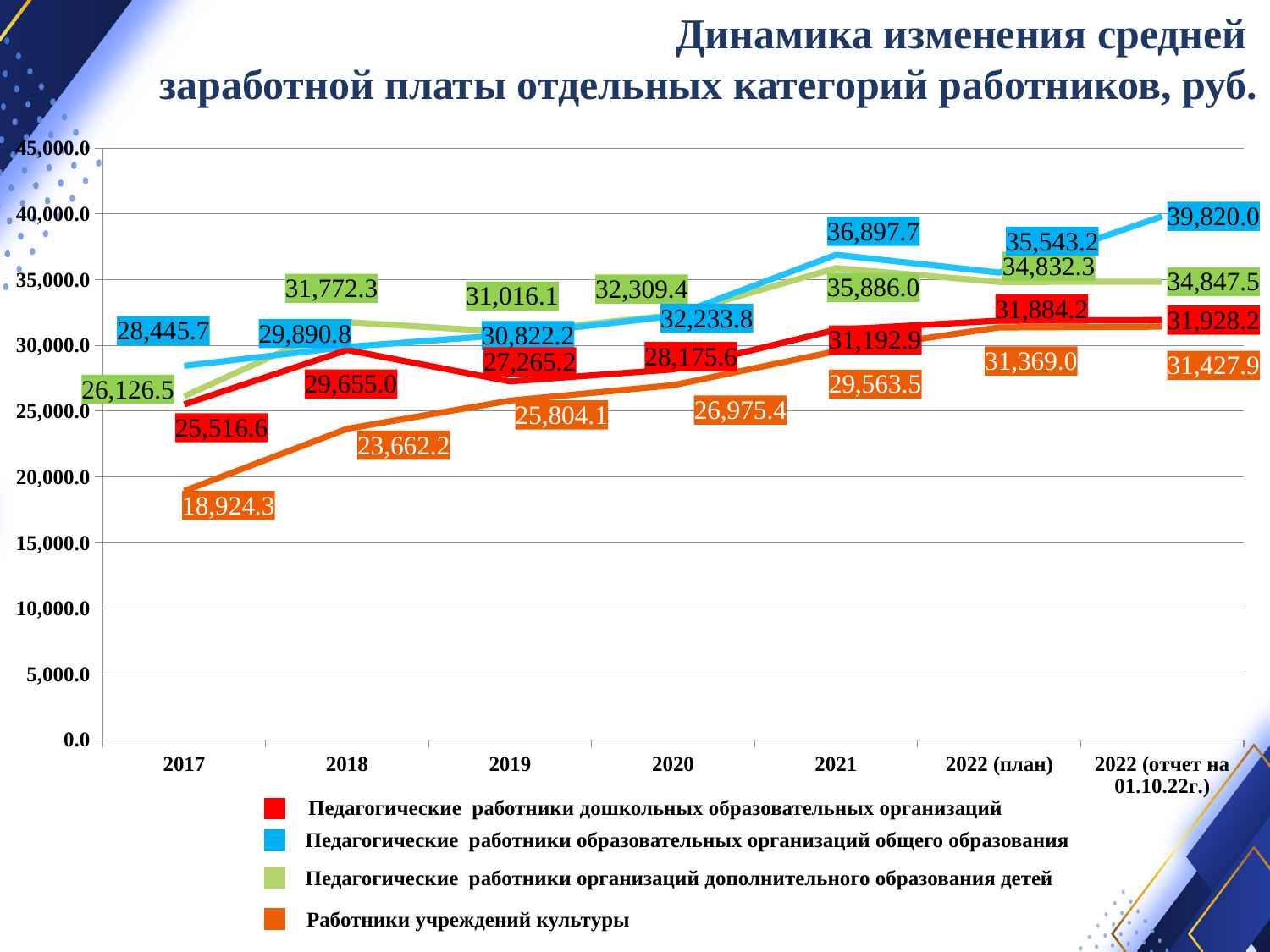
How many points along the x axis does the chart have? 7 What is the value for Педагогические работники образовательных организаций общего образования in 2022 (отчет на 01.10.22г.)? 39,820.0 How many series does the legend list? 4 What is the difference between the 2021 values for Педагогические работники образовательных организаций общего образования and Педагогические работники дошкольных образовательных организаций? 5,704.8 In which period is the value for Педагогические работники образовательных организаций общего образования highest? 2022 (отчет на 01.10.22г.) What is the value for Работники учреждений культуры in 2017? 18,924.3 What colour is the line for Работники учреждений культуры? orange What kind of chart is shown on the slide? line chart Does the value for Работники учреждений культуры rise or fall from 2017 to 2022 (отчет на 01.10.22г.)? rise In 2018, which is larger: the value for Педагогические работники организаций дополнительного образования детей or for Педагогические работники образовательных организаций общего образования? Педагогические работники организаций дополнительного образования детей What is the value for Педагогические работники организаций дополнительного образования детей in 2020? 32,309.4 In which year is the value for Работники учреждений культуры lowest? 2017